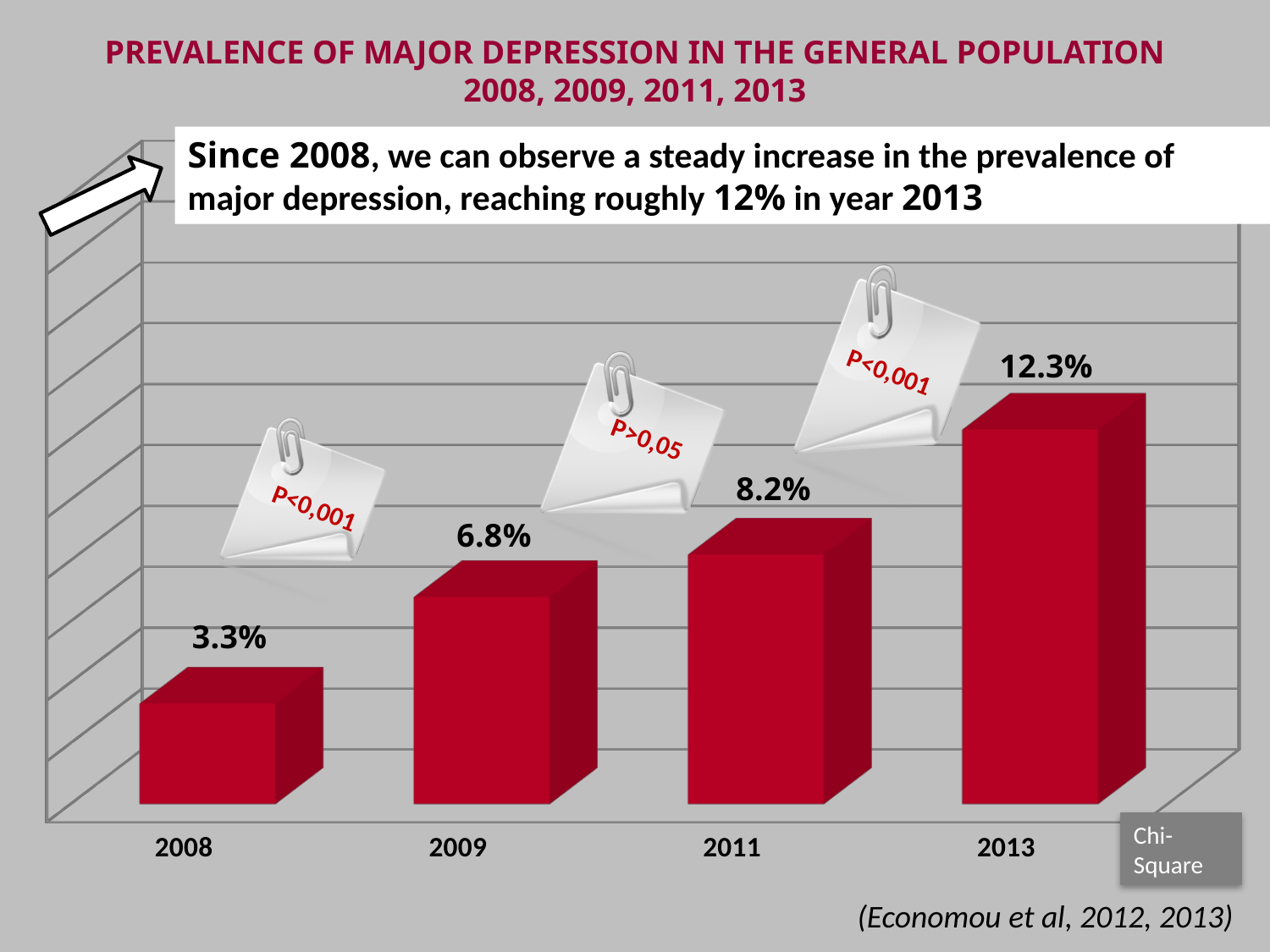
What is the prevalence of major depression shown for 2008? 3.3% What kind of chart is shown on the slide? Bar chart What is the difference in prevalence between 2011 and 2009? 1.4 percentage points What is the prevalence of major depression shown for 2009? 6.8% What is the difference in prevalence between 2013 and 2008? 9 percentage points Which year has the lowest prevalence of major depression? 2008 How many years are plotted in the chart? 4 Which year has the highest prevalence of major depression? 2013 Which year has a higher prevalence, 2009 or 2011? 2011 What is the prevalence of major depression shown for 2013? 12.3% What is the prevalence of major depression shown for 2011? 8.2% Do the prevalence values rise or fall from 2008 to 2013? Rise